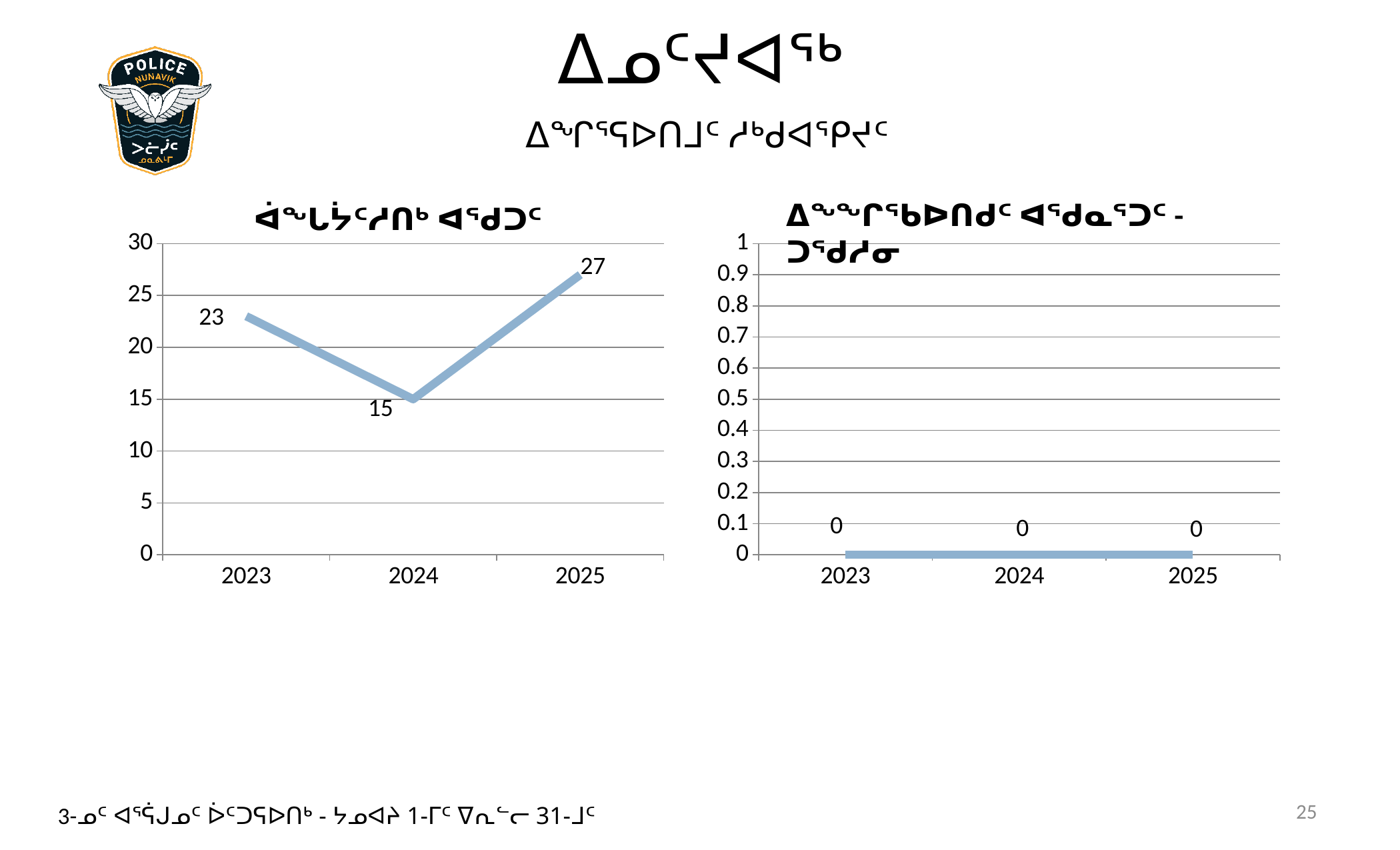
In the right chart, do the values rise, fall, or stay flat from 2023 to 2025? stay flat In the left chart, which year has the highest value? 2025 In the left chart, what is the value for 2024? 15 In the left chart, which year has the lowest value? 2024 In the left chart, what is the value for 2025? 27 In the left chart, how many years are plotted on the x axis? 3 In the left chart, is the value for 2024 greater or less than 20? less In the left chart, what is the difference between the values for 2025 and 2024? 12 What kind of chart is the left chart? line chart In the left chart, what is the value for 2023? 23 In the right chart, what is the value for 2024? 0 In the left chart, which is larger, the value for 2023 or the value for 2025? 2025